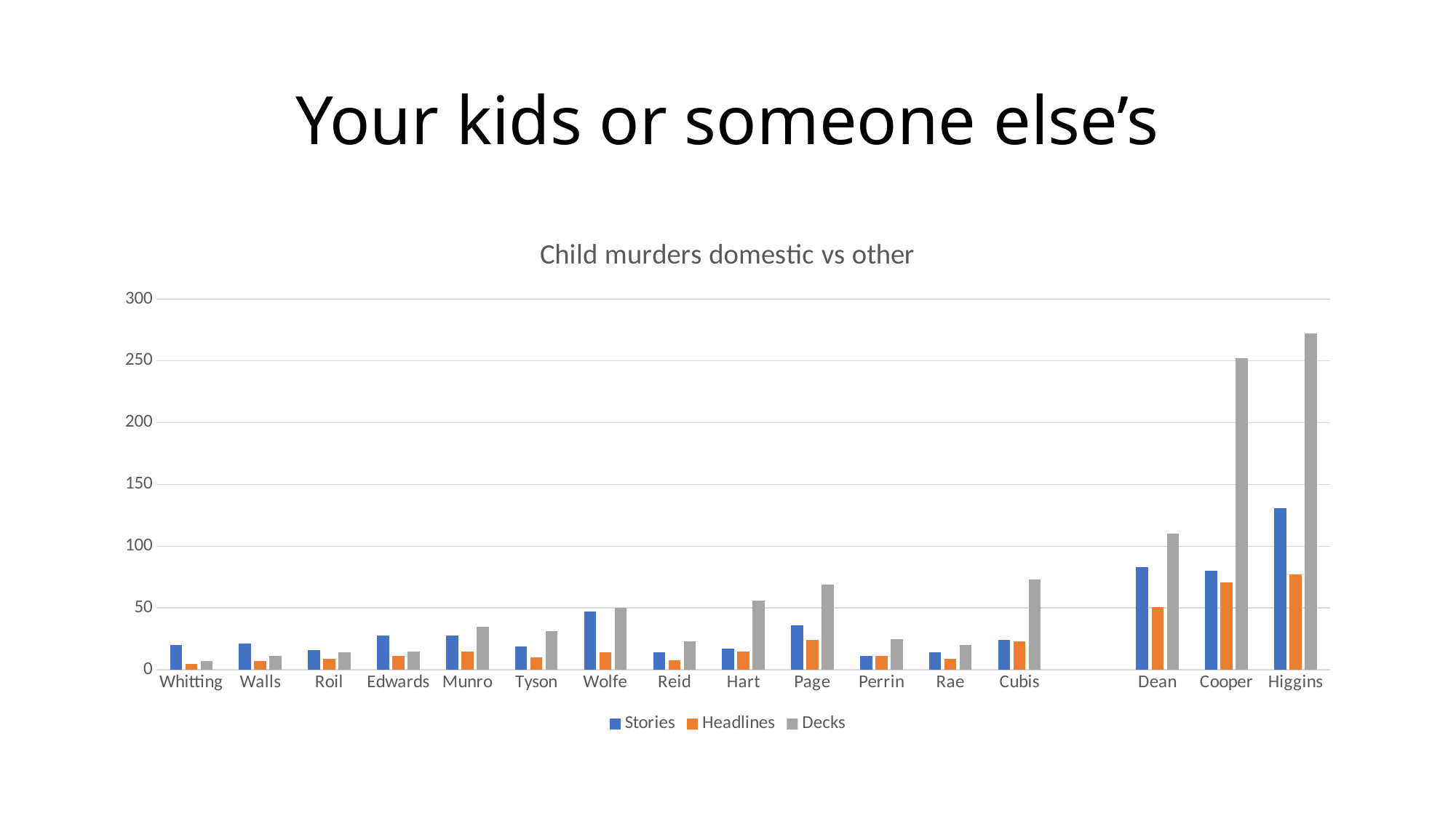
Which category has the highest Decks value? Higgins What is the title of the chart? Child murders domestic vs other How many series does the legend list? 3 For Dean, which is larger: the Stories value or the Headlines value? Stories What kind of chart is shown on the slide? Bar chart Is the Decks value for Higgins greater or less than 250? greater Is the Headlines value for Cooper greater or less than 50? greater Which series is shown in grey in the legend? Decks Which category has the lowest Decks value? Whitting Is the Stories value for Higgins greater or less than 100? greater Which category has the highest Stories value? Higgins